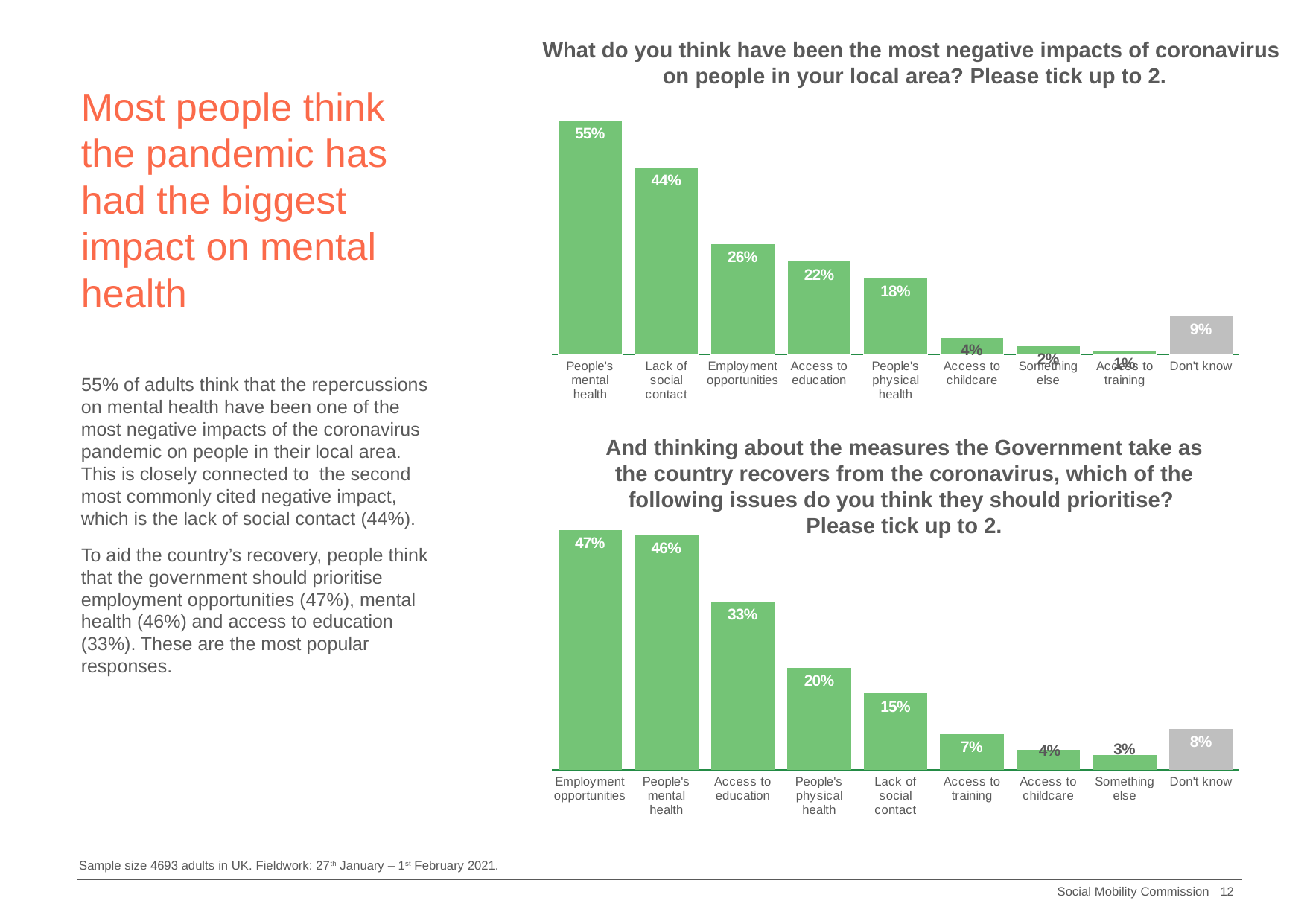
In the top chart (most negative impacts of coronavirus), which category has the highest value? People's mental health In the top chart (most negative impacts of coronavirus), what is the value for Access to education? 22% What type of chart is the bottom chart (issues the Government should prioritise)? Bar chart In the bottom chart (issues the Government should prioritise), what is the value for Access to education? 33% In the top chart (most negative impacts of coronavirus), which category has the lowest value? Access to training In the bottom chart (issues the Government should prioritise), which is larger: People's physical health or Don't know? People's physical health In the bottom chart (issues the Government should prioritise), which category has the highest value? Employment opportunities In the bottom chart (issues the Government should prioritise), what is the difference between Employment opportunities and People's mental health? 1 percentage point In the top chart (most negative impacts of coronavirus), how many categories are shown? 9 In the top chart (most negative impacts of coronavirus), what is the value for People's mental health? 55% In the bottom chart (issues the Government should prioritise), what is the value for Lack of social contact? 15% In the top chart (most negative impacts of coronavirus), what is the difference between People's mental health and Lack of social contact? 11 percentage points